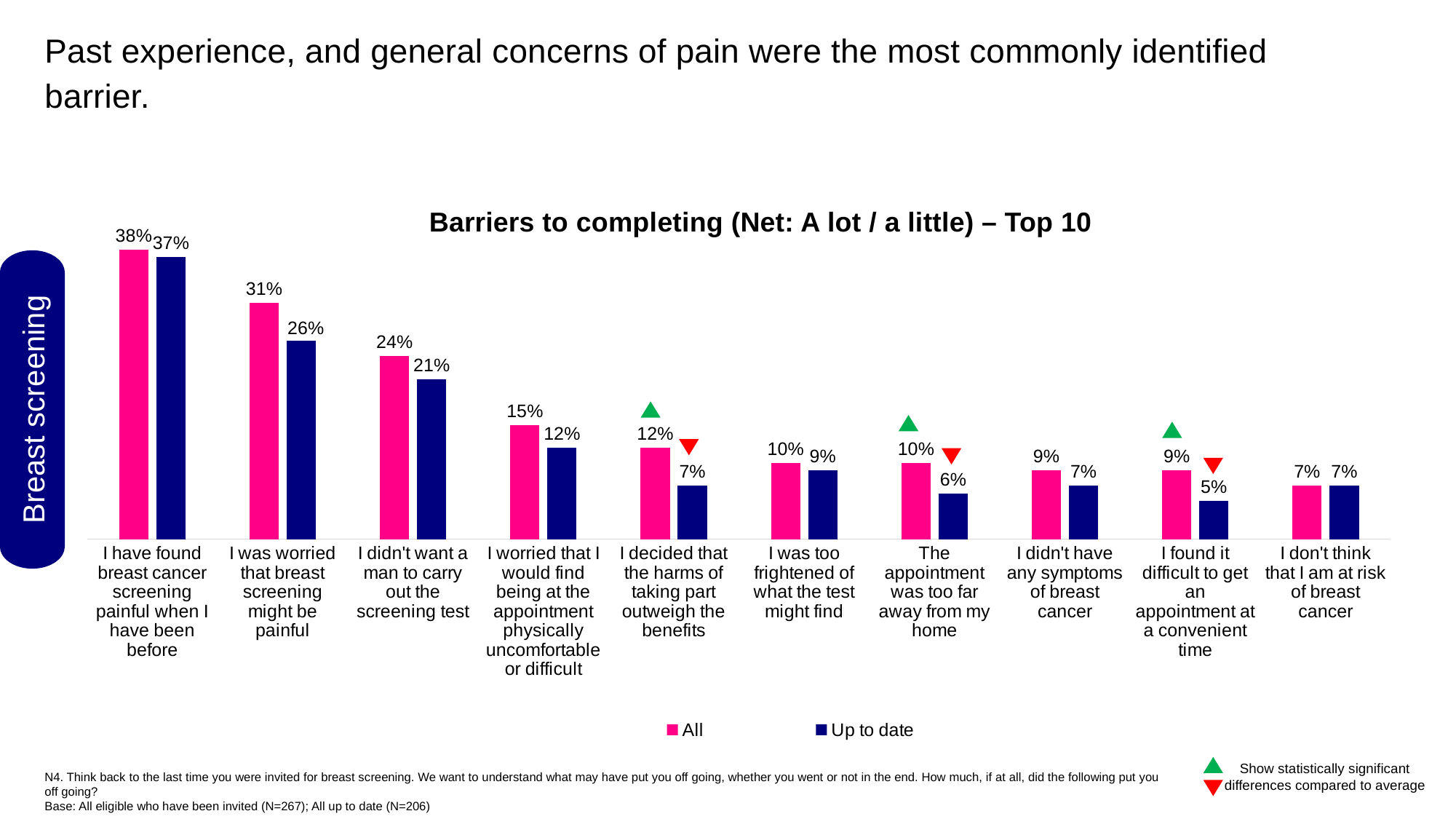
How many series does the legend list? 2 What is the title of the chart? Barriers to completing (Net: A lot / a little) – Top 10 What is the value for "Up to date" for "I found it difficult to get an appointment at a convenient time"? 5% Do the "All" values rise or fall moving from left to right along the x axis? Fall How many categories are shown on the x axis of the chart? 10 Which category has the highest value for the "All" series? I have found breast cancer screening painful when I have been before What is the difference between the "All" and "Up to date" values for "I didn't want a man to carry out the screening test"? 3% For "I decided that the harms of taking part outweigh the benefits", which series has the larger value, "All" or "Up to date"? All Which category has the lowest value for the "Up to date" series? I found it difficult to get an appointment at a convenient time What is the value for "Up to date" for "I was worried that breast screening might be painful"? 26% What is the value for "All" for "I have found breast cancer screening painful when I have been before"? 38% What kind of chart is shown on the slide? Bar chart